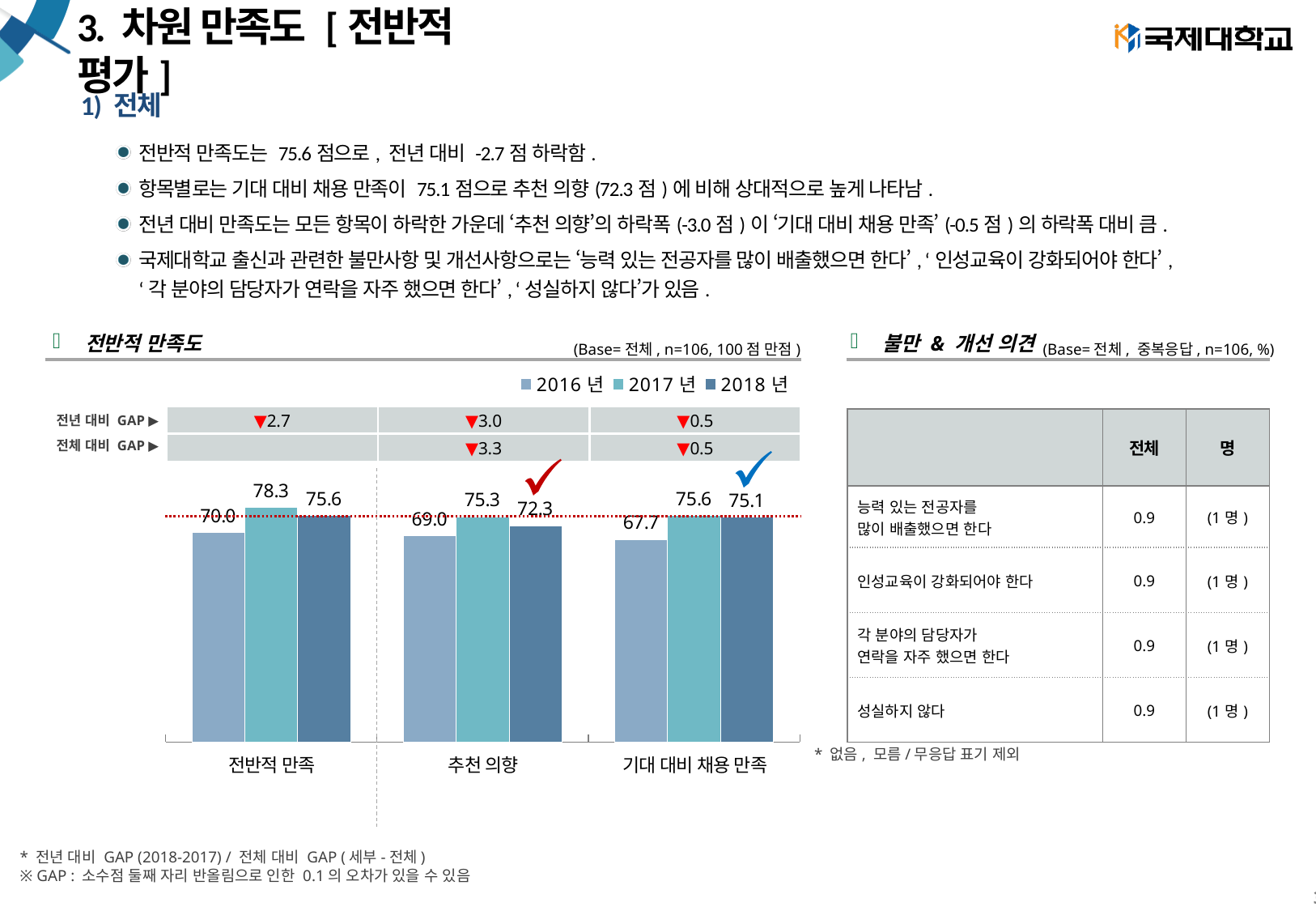
In the 전반적 만족도 chart, what is the 2018년 value for 전반적 만족? 75.6 In the 전반적 만족도 chart, what is the 전년 대비 GAP shown for 추천 의향? ▼3.0 In the 전반적 만족도 chart, what is the 2016년 value for 기대 대비 채용 만족? 67.7 In the 전반적 만족도 chart, which is larger for 기대 대비 채용 만족: the 2017년 value or the 2018년 value? 2017년 In the 전반적 만족도 chart, what is the difference between the 2017년 and 2018년 values for 전반적 만족? 2.7 How many series does the legend of the 전반적 만족도 chart list? 3 In the 전반적 만족도 chart, what is the 2017년 value for 추천 의향? 75.3 In the 전반적 만족도 chart, which category has the highest 2017년 value? 전반적 만족 In the 전반적 만족도 chart, what is the 2018년 value for 추천 의향? 72.3 What kind of chart is the 전반적 만족도 chart? bar chart In the 전반적 만족도 chart, which category has the lowest 2016년 value? 기대 대비 채용 만족 How many categories are shown on the x axis of the 전반적 만족도 chart? 3